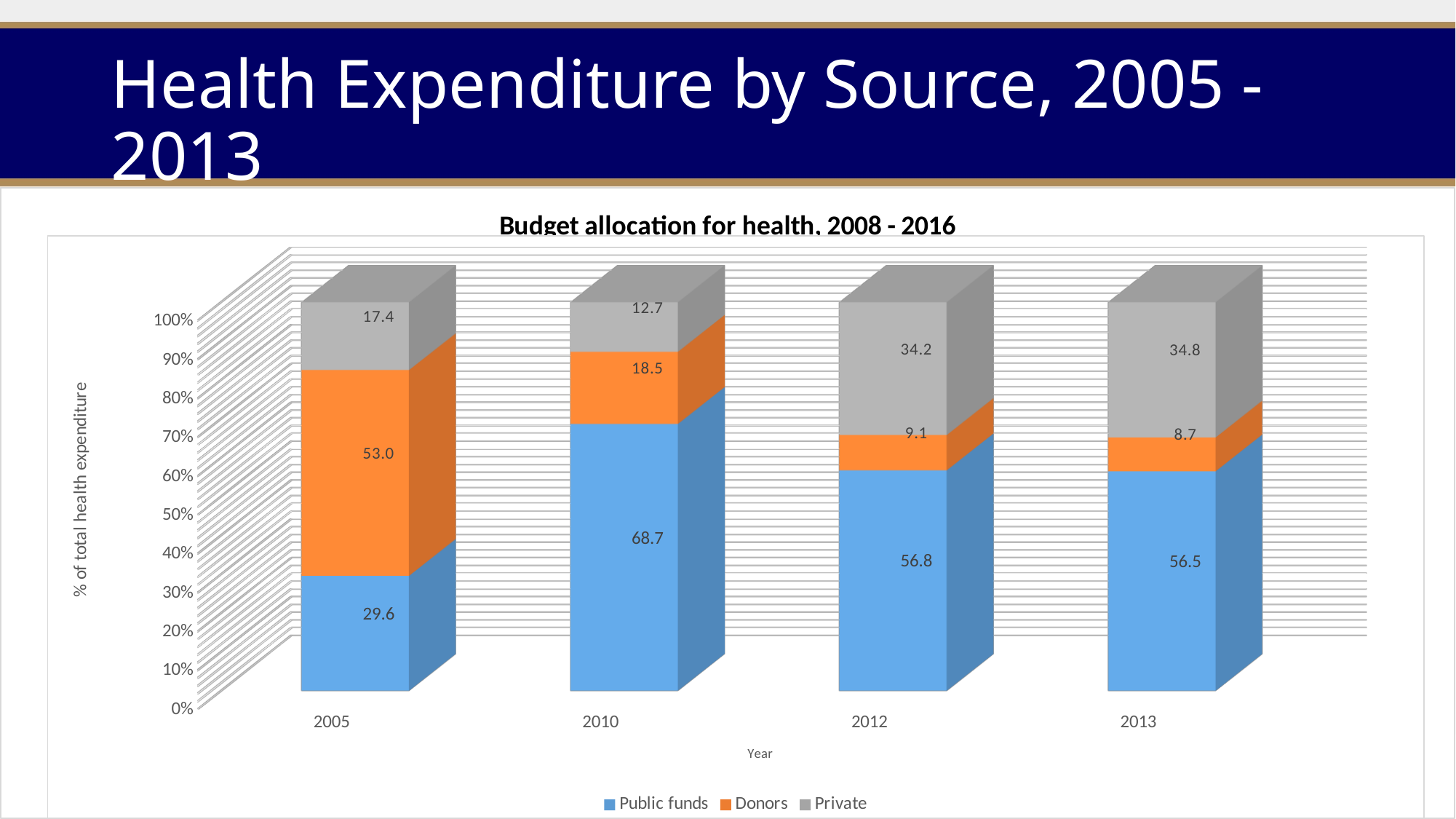
What kind of chart is shown on the slide? Stacked bar chart How many series does the legend list? 3 What is the value for Public funds in 2005? 29.6 What is the value for Private in 2013? 34.8 Does the Donors value rise or fall from 2005 to 2013? Fall How many years are shown on the x axis? 4 What is the value for Donors in 2010? 18.5 What is the title of the chart? Budget allocation for health, 2008 - 2016 What is the difference between the Private values for 2012 and 2005? 16.8 In which year is the Public funds value lowest? 2005 In which year is the Donors value highest? 2005 Which is larger: the Donors value in 2012 or the Donors value in 2013? 2012